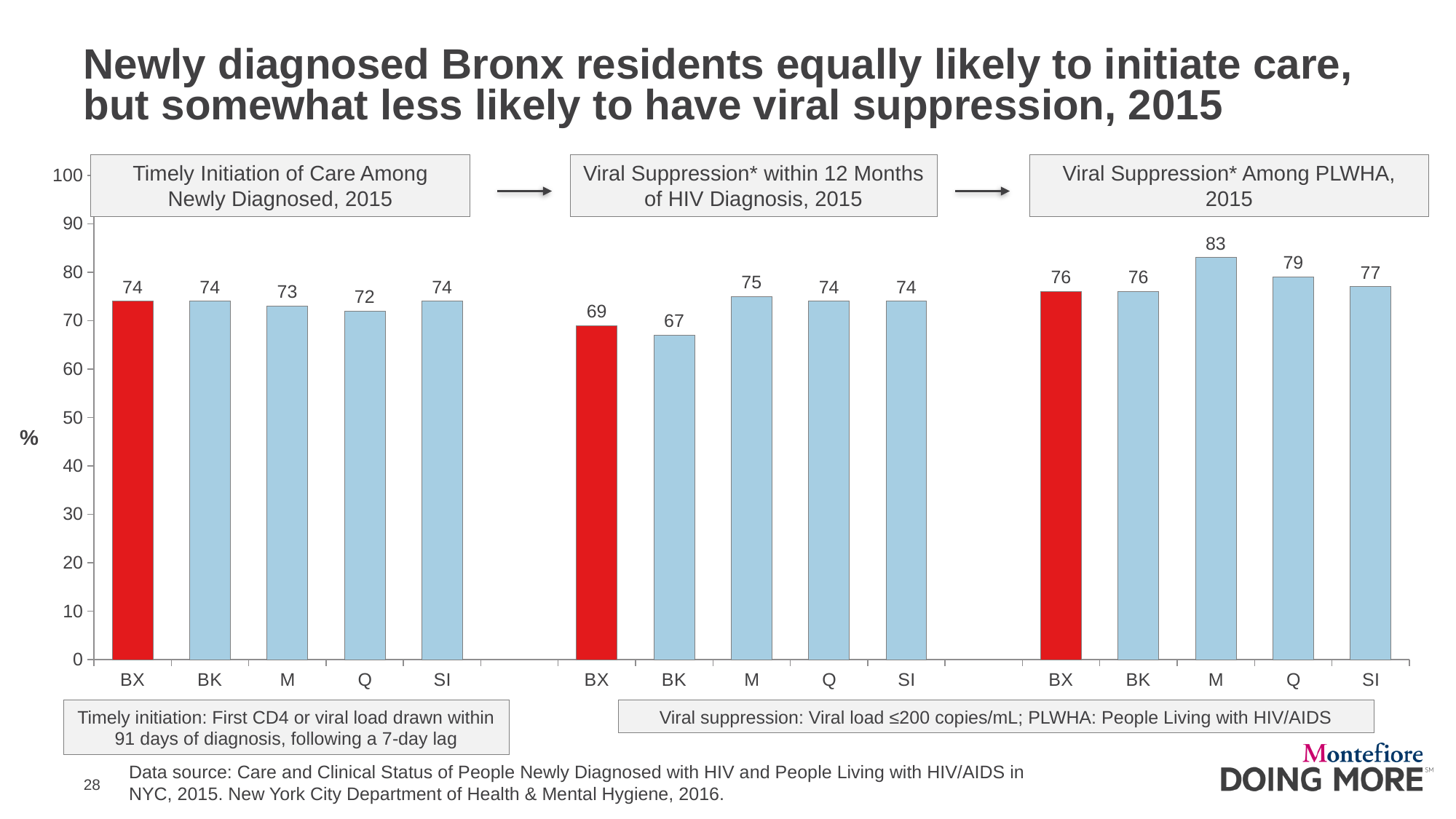
In the "Viral Suppression* within 12 Months of HIV Diagnosis, 2015" section, which is larger, the value for BX or the value for M? M In the "Viral Suppression* Among PLWHA, 2015" section, what is the difference between the values for M and BX? 7 In the "Timely Initiation of Care Among Newly Diagnosed, 2015" section, what is the value for BX? 74 In the "Viral Suppression* within 12 Months of HIV Diagnosis, 2015" section, is the value for BX greater or less than 70? less How many boroughs are shown in each section of the chart? 5 Which borough's bars are coloured red in the chart? BX What kind of chart is shown on the slide? bar chart In the "Viral Suppression* Among PLWHA, 2015" section, what is the value for Q? 79 In the "Timely Initiation of Care Among Newly Diagnosed, 2015" section, which borough has the lowest value? Q In the "Viral Suppression* Among PLWHA, 2015" section, which borough has the highest value? M In the "Viral Suppression* within 12 Months of HIV Diagnosis, 2015" section, what is the value for BK? 67 In the "Viral Suppression* within 12 Months of HIV Diagnosis, 2015" section, which borough has the lowest value? BK